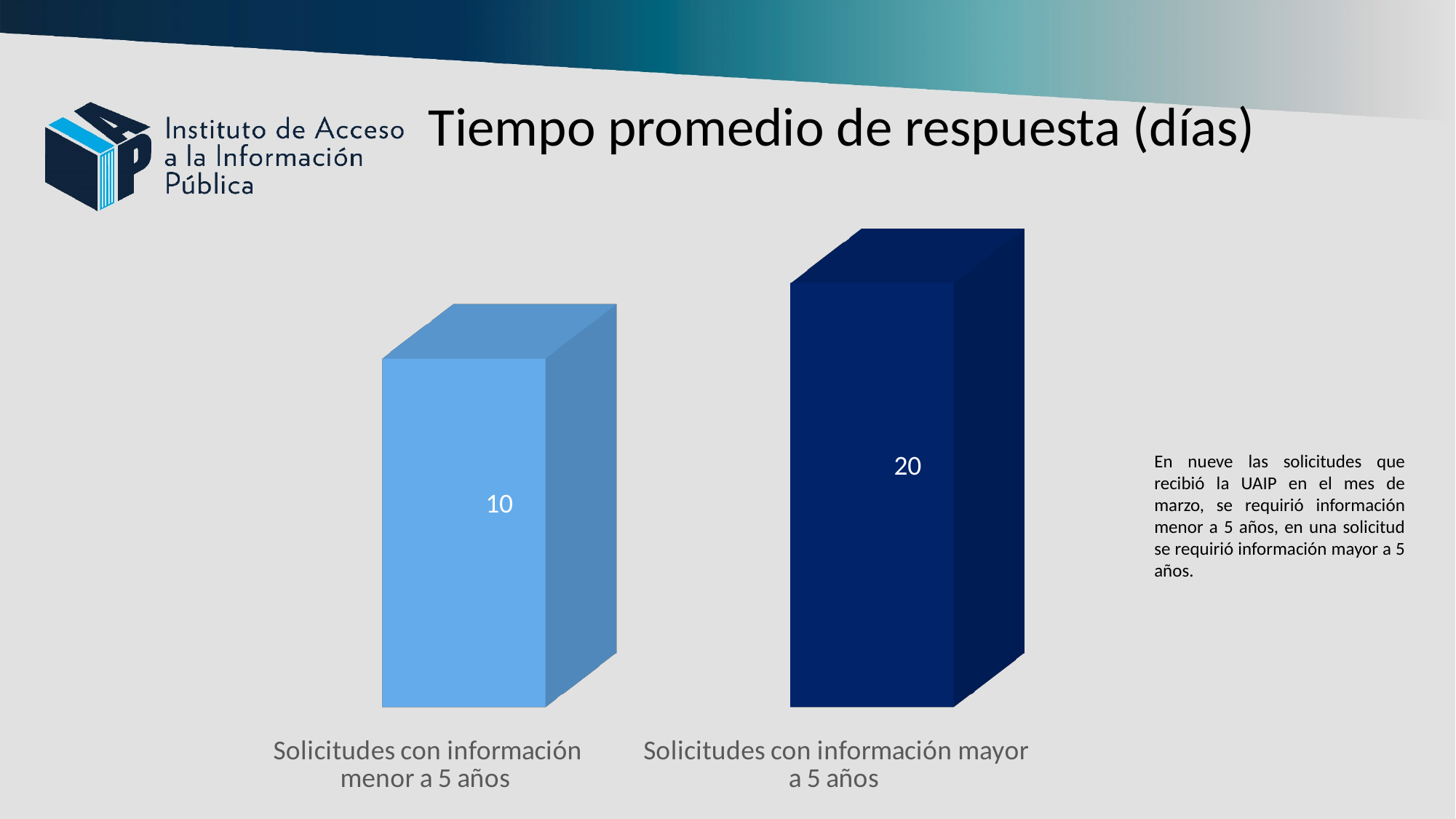
What colour is the bar for 'Solicitudes con información mayor a 5 años'? Dark blue What kind of chart is shown on the slide? Bar chart What is the difference in days between the response time for requests with information older than 5 years and requests with information less than 5 years old? 10 Which category has the highest average response time? Solicitudes con información mayor a 5 años Which is larger: the response time for 'Solicitudes con información menor a 5 años' or for 'Solicitudes con información mayor a 5 años'? Solicitudes con información mayor a 5 años What is the average response time in days for 'Solicitudes con información mayor a 5 años'? 20 What is the title of the chart? Tiempo promedio de respuesta (días) What is the average response time in days for 'Solicitudes con información menor a 5 años'? 10 Which category has the lowest average response time? Solicitudes con información menor a 5 años How many categories are shown in the chart? 2